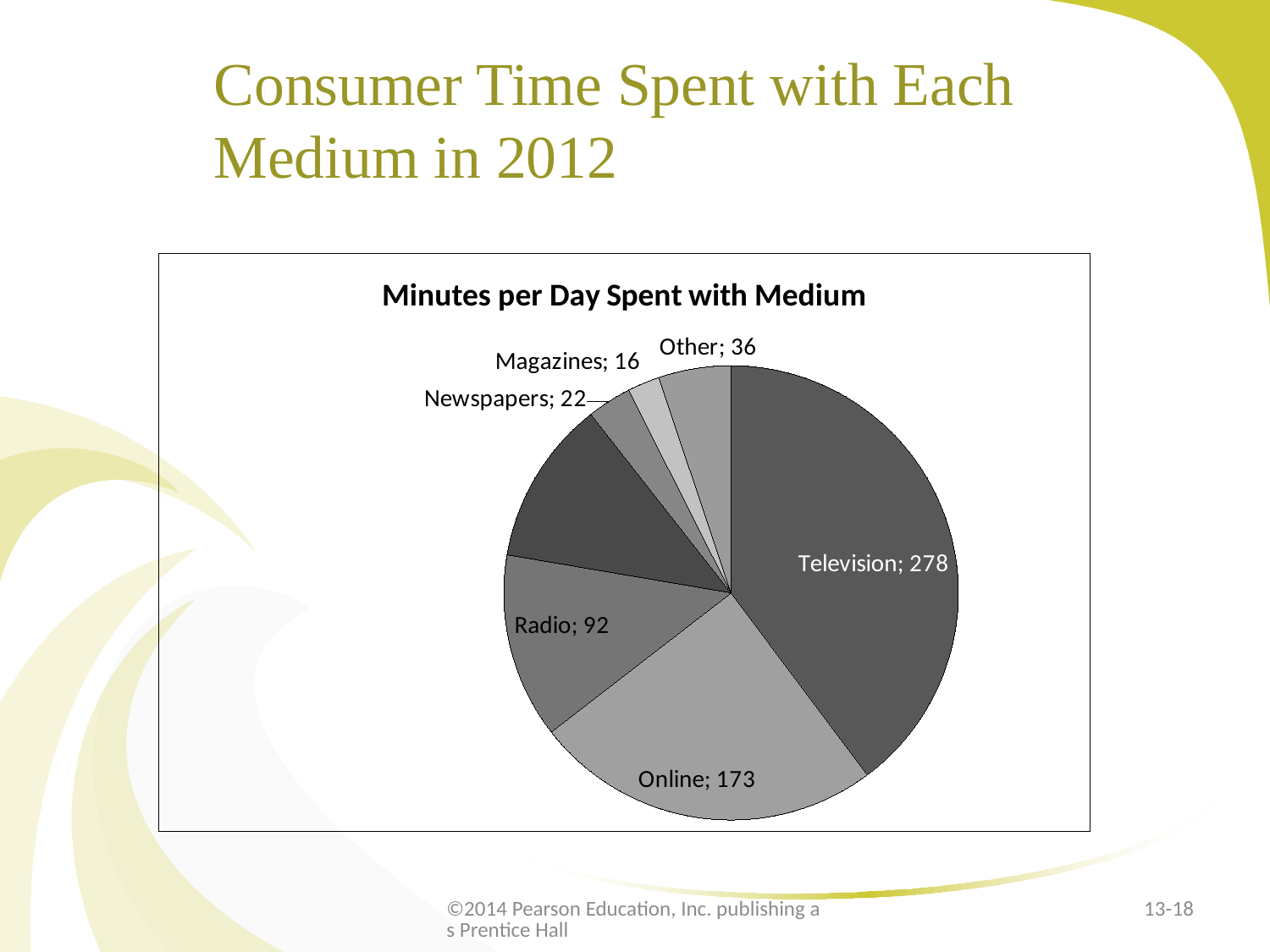
What type of chart is shown on the slide? pie chart Which medium has the largest slice of the pie? Television What is the value shown for the Other slice? 36 Which medium has the smallest slice of the pie? Magazines Which is larger, the value for Radio or the value for Other? Radio How many media categories are shown in the pie chart? 7 What is the value shown for Newspapers? 22 What is the difference between the values for Television and Online? 105 What is the value for Radio in the pie chart? 92 What is the title of the chart? Minutes per Day Spent with Medium How many minutes per day are spent with Television? 278